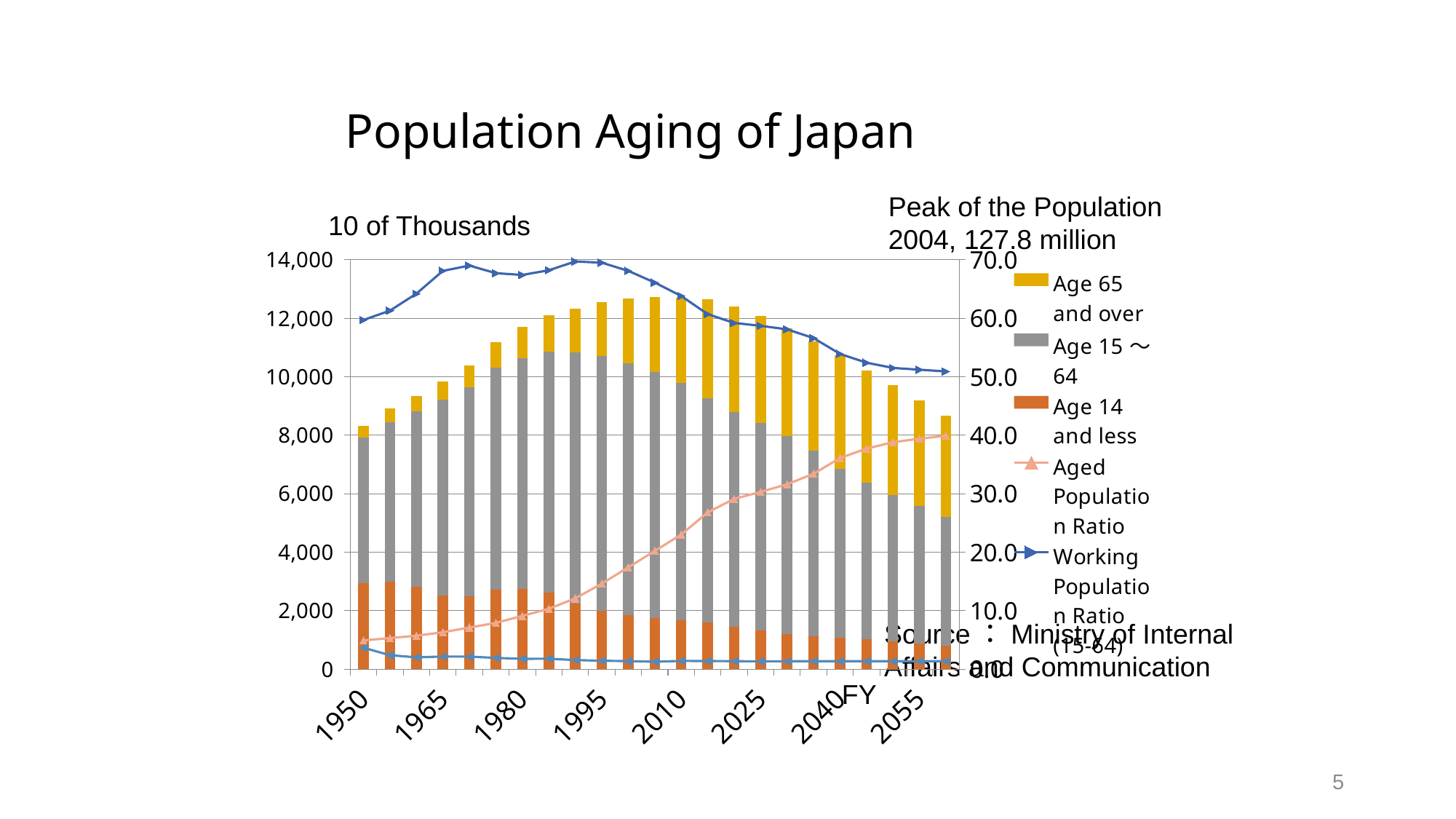
How many series does the chart's legend list? 5 What is the title of the chart on the slide? Population Aging of Japan Does the Aged Population Ratio line rise or fall from 1950 to 2055? Rise What kind of chart is shown on the slide? A stacked bar chart combined with line series How many year labels are shown on the x axis of the chart? 8 In 2055, which is larger: the Working Population Ratio or the Aged Population Ratio? Working Population Ratio What unit is given for the left vertical axis of the chart? 10 of Thousands Is the Aged Population Ratio for 1950 greater or less than 10.0? less In which year is the Aged Population Ratio lowest? 1950 Is the total stacked bar for 2055 greater or less than 10,000? less Is the Working Population Ratio for 1995 greater or less than 60.0? greater